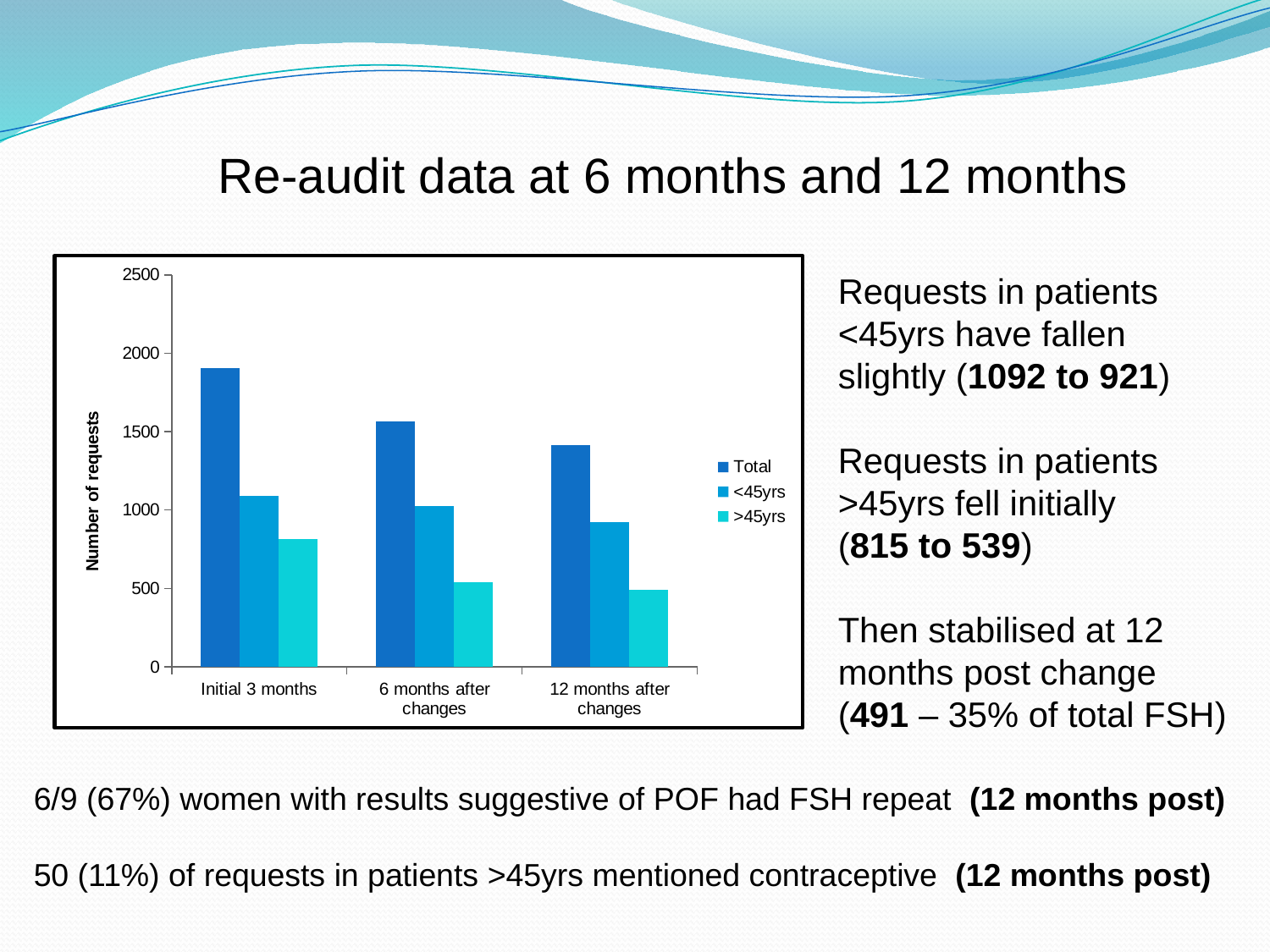
What kind of chart is shown on the slide? bar chart In which period is the Total bar highest? Initial 3 months Does the Total number of requests rise or fall from Initial 3 months to 12 months after changes? fall Is the Total value for Initial 3 months greater or less than 1500? greater Is the >45yrs value for Initial 3 months greater or less than 1000? less How many time-period categories are shown on the x axis of the chart? 3 Is the Total value for 12 months after changes greater or less than 1500? less What is the title of the vertical axis of the chart? Number of requests Which series are listed in the chart legend? Total, <45yrs, >45yrs How many series does the chart legend list? 3 In which period is the Total bar lowest? 12 months after changes